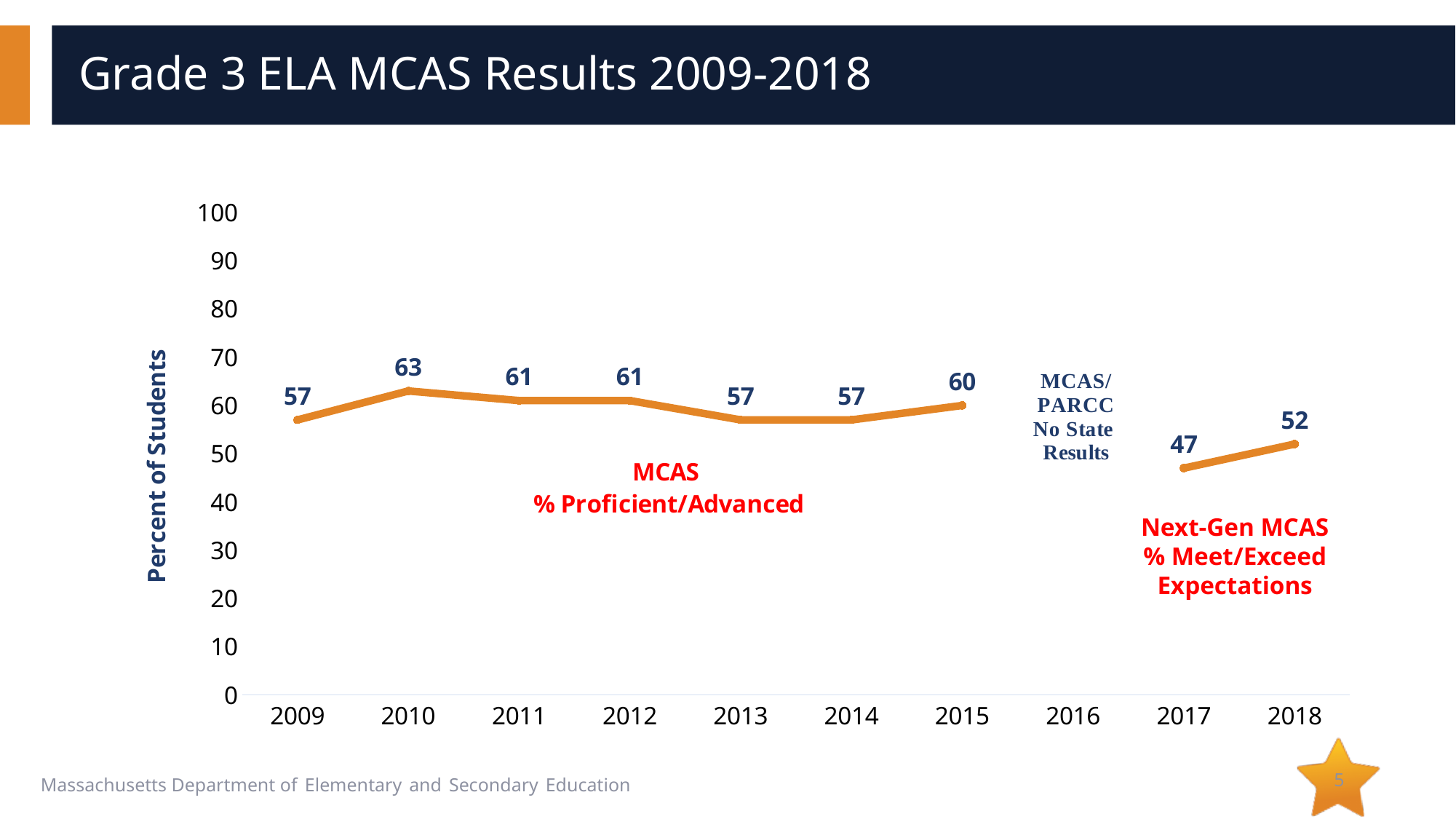
Do the values rise or fall from 2017 to 2018? rise Which is larger, the value for 2015 or the value for 2013? 2015 What is the value for 2010? 63 What is the value for 2018? 52 Which year has the lowest plotted value? 2017 What is the title of the chart? Grade 3 ELA MCAS Results 2009-2018 What is the difference between the values for 2018 and 2017? 5 What is the value for 2015? 60 What is the difference between the values for 2010 and 2009? 6 Which year has the highest value? 2010 Is the value for 2017 greater or less than 50? less What kind of chart is this? line chart